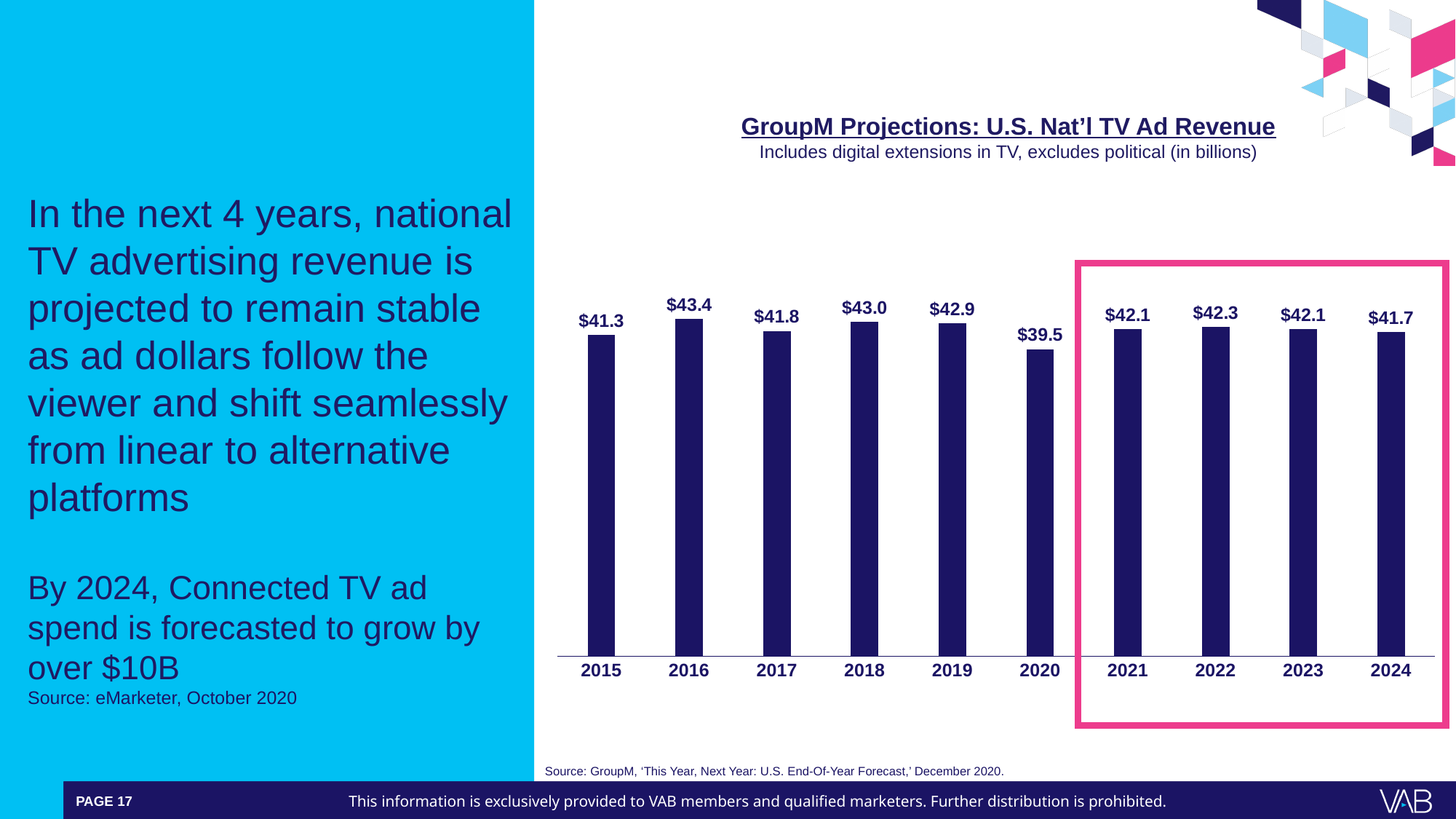
What is the value shown for 2016? $43.4 What is the projected U.S. national TV ad revenue for 2020? $39.5 Which years are enclosed by the pink box on the chart? 2021 to 2024 What is the title of the chart? GroupM Projections: U.S. Nat'l TV Ad Revenue Which year has the lowest value on the chart? 2020 What is the projected value for 2024? $41.7 Which is larger, the value for 2018 or the value for 2019? 2018 Do the values rise or fall from 2022 to 2024? Fall How many years are shown on the chart? 10 What kind of chart is shown on the slide? Bar chart What is the difference between the 2016 value and the 2020 value? $3.9 Which year has the highest value on the chart? 2016